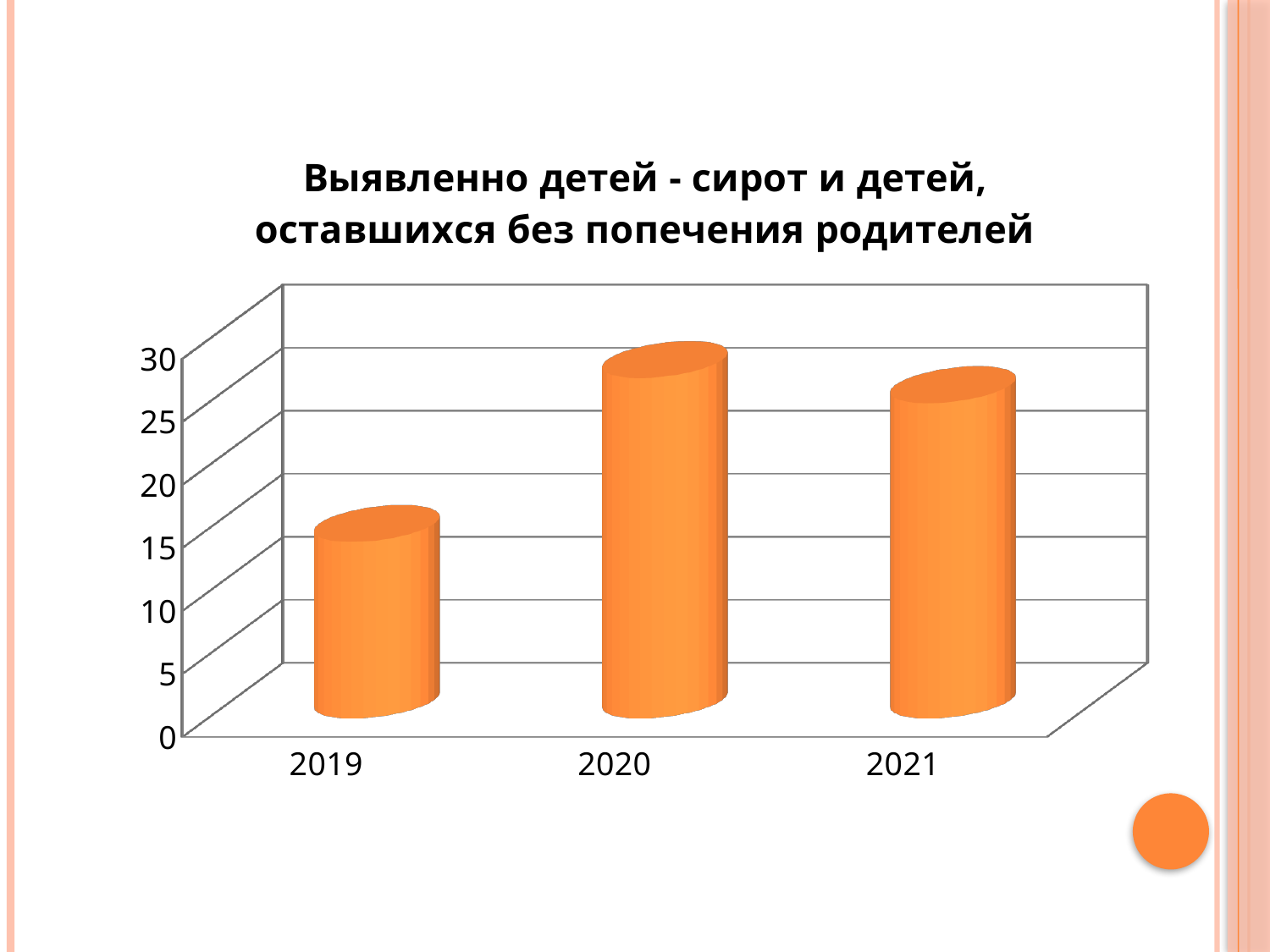
Does the value rise or fall from 2019 to 2020? rise What is the title of the chart? Выявленно детей - сирот и детей, оставшихся без попечения родителей How many years are shown on the x axis of the chart? 3 Is the value for 2019 greater or less than 20? less What kind of chart is shown on the slide? bar chart Is the value for 2019 greater or less than 10? greater What colour are the bars in the chart? orange Is the value for 2020 greater or less than 25? greater Which year has the lowest value in the chart? 2019 Which is larger, the value for 2019 or the value for 2021? 2021 Which year has the highest value in the chart? 2020